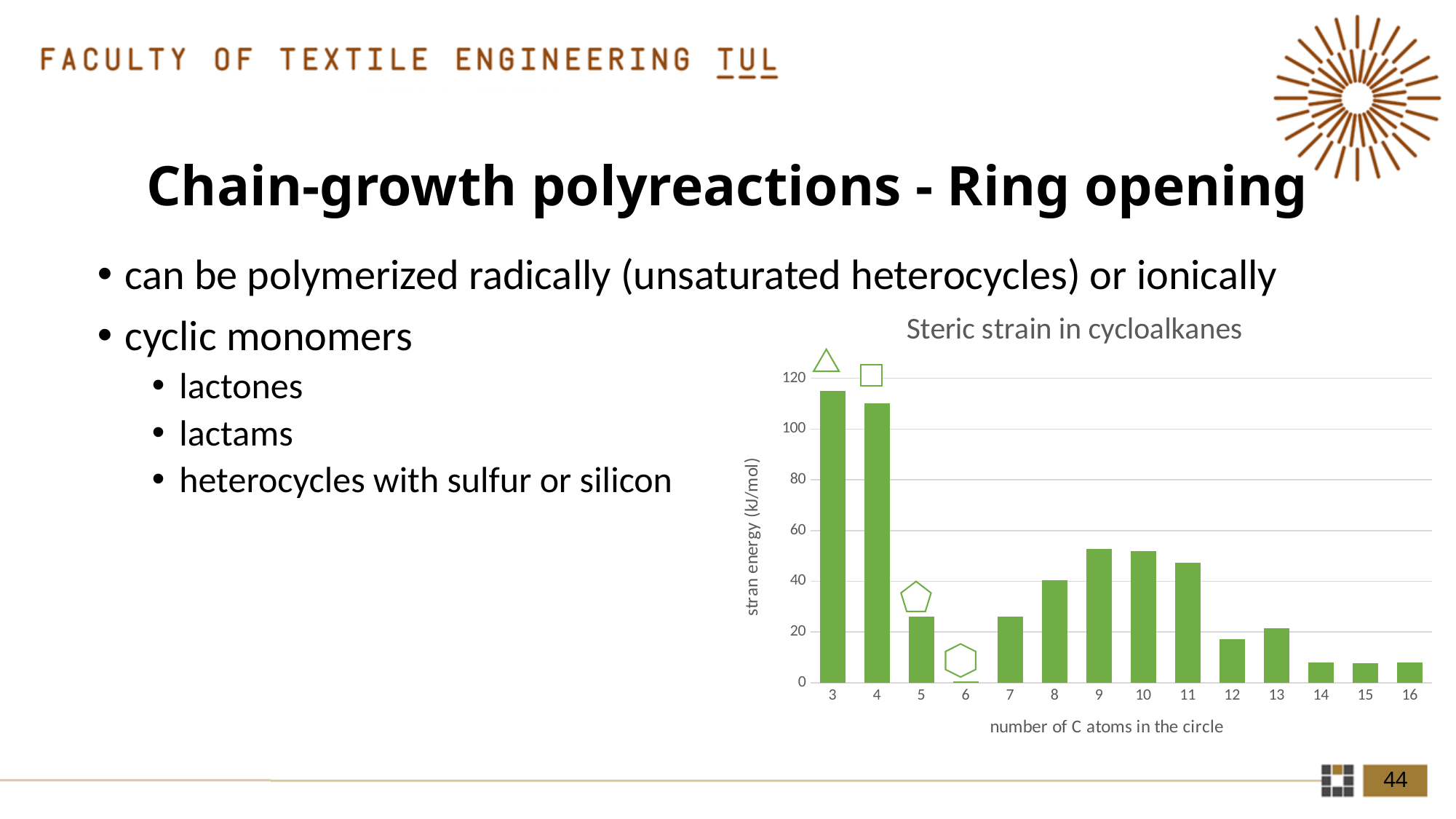
Which number of C atoms has the lowest strain energy? 6 What is the title of the chart? Steric strain in cycloalkanes Is the strain energy for 5 C atoms greater or less than 40? less Is the strain energy for 14 C atoms greater or less than 20? less Do the strain energy values rise or fall from 7 to 9 C atoms? rise What is the label of the y axis? stran energy (kJ/mol) Which has a higher strain energy, 8 C atoms or 12 C atoms? 8 Which number of C atoms has the highest strain energy? 3 Is the strain energy for 9 C atoms greater or less than 40? greater What kind of chart is shown on the slide? bar chart How many categories (numbers of C atoms) are plotted along the x axis? 14